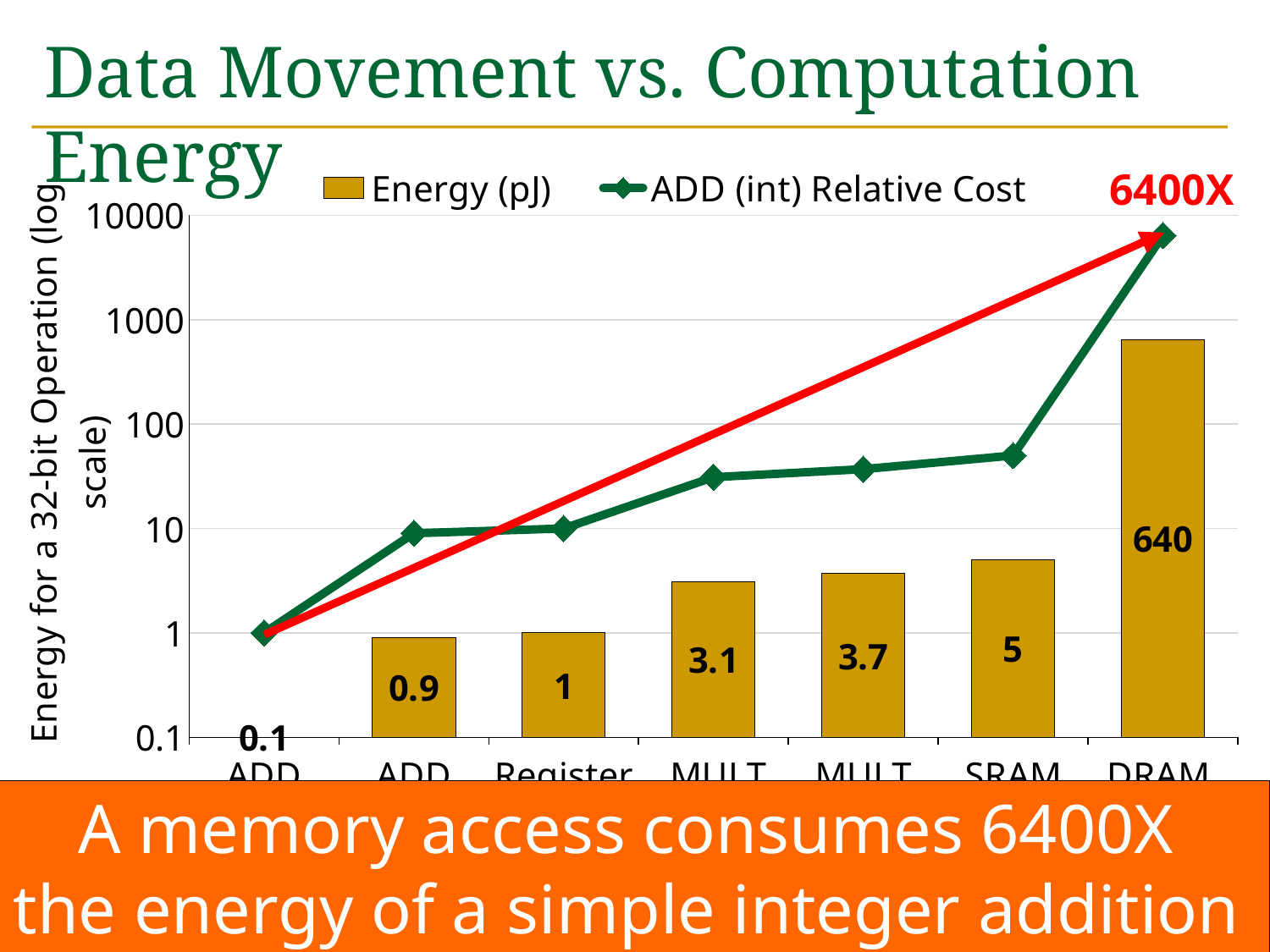
Does the ADD (int) Relative Cost line rise or fall from left to right along the x axis? Rise What is the lowest Energy (pJ) value shown on the chart? 0.1 Which category has the highest Energy (pJ) value? DRAM What is the Energy (pJ) value for SRAM? 5 What kind of chart is shown on the slide? Combined bar and line chart How many categories are shown on the x axis? 7 How many series does the legend list? 2 Is the ADD (int) Relative Cost value for DRAM greater or less than 1000? greater What is the difference between the Energy (pJ) values for DRAM and SRAM? 635 Which has a larger Energy (pJ) value, SRAM or Register? SRAM What is the Energy (pJ) value for DRAM? 640 What is the Energy (pJ) value for Register? 1